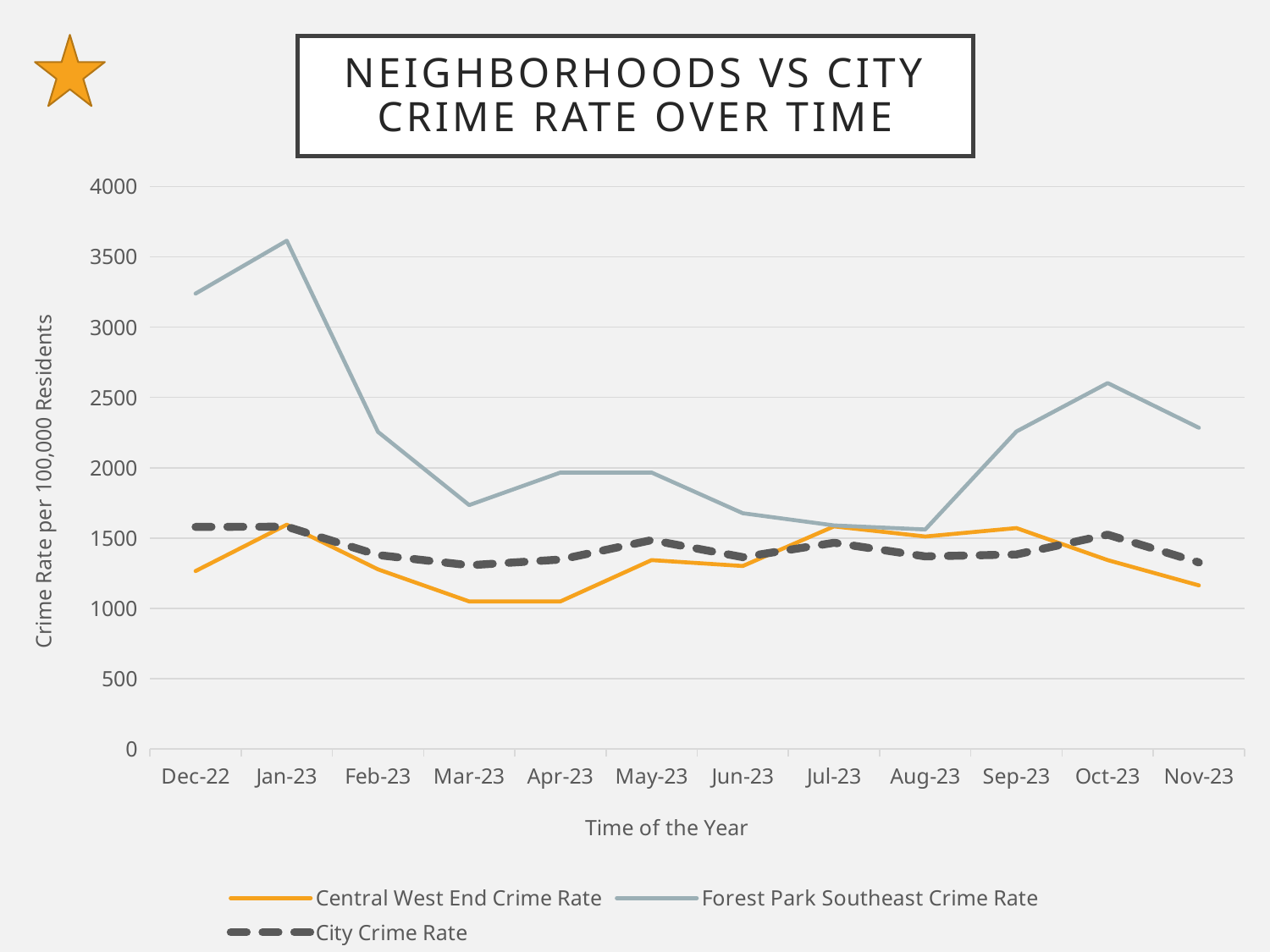
Is the Central West End Crime Rate for Mar-23 greater or less than 1500? less Is the Forest Park Southeast Crime Rate for Jan-23 greater or less than 3500? greater Which is higher in Mar-23, the Central West End Crime Rate or the City Crime Rate? City Crime Rate What is the title of the chart? Neighborhoods vs City Crime Rate Over Time How many series does the legend list? 3 Is the Forest Park Southeast Crime Rate for Oct-23 greater or less than 2500? greater Does the Forest Park Southeast Crime Rate rise or fall from Jan-23 to Mar-23? fall What kind of chart is shown on the slide? line chart Which series has the higher value in Dec-22, Central West End Crime Rate or Forest Park Southeast Crime Rate? Forest Park Southeast Crime Rate Which series is drawn with a dashed line? City Crime Rate In which month is the Forest Park Southeast Crime Rate highest? Jan-23 How many months are shown along the x axis? 12